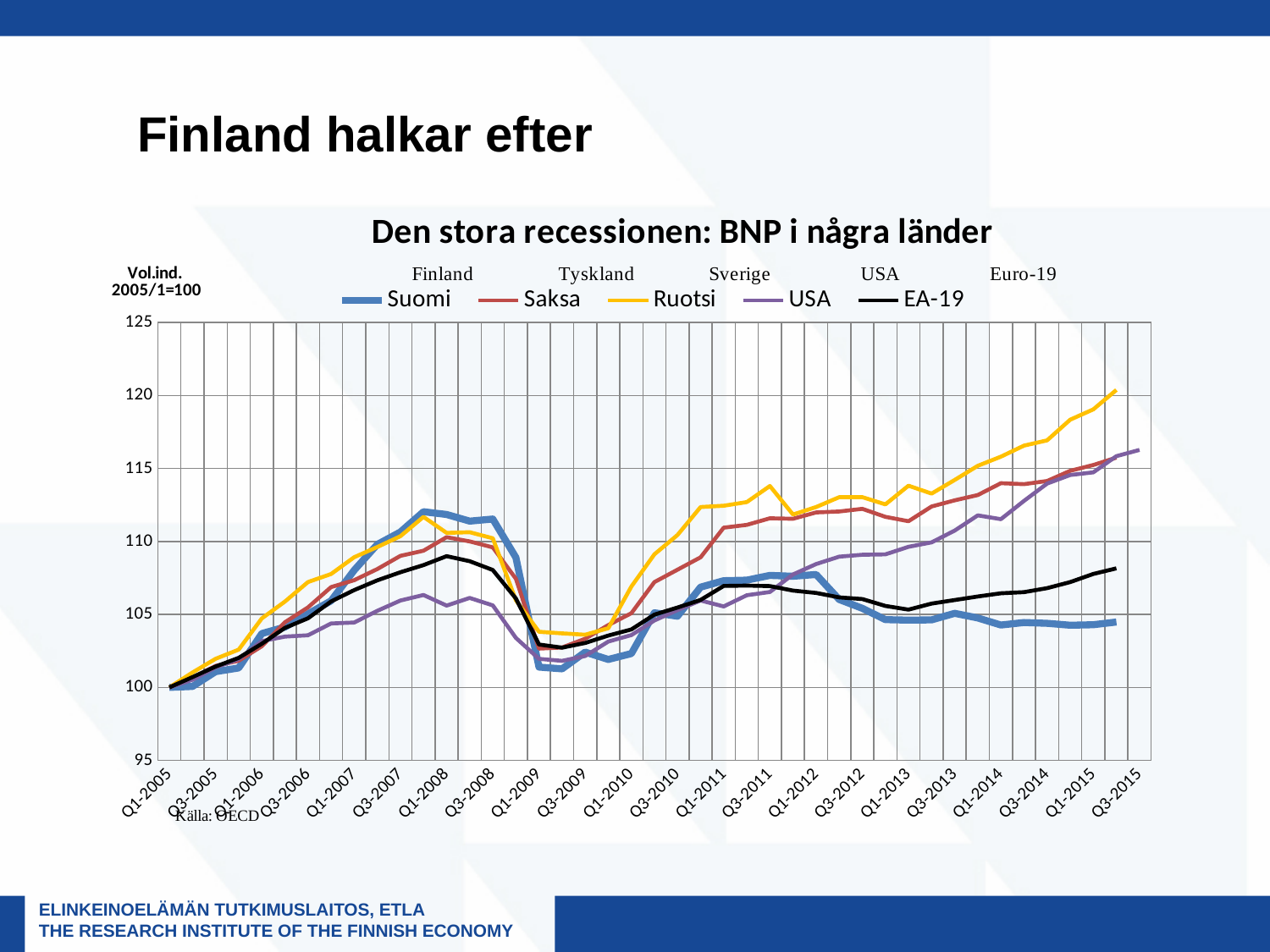
At Q1-2008, which series is higher, Suomi or USA? Suomi Does the Suomi series rise or fall between Q1-2011 and Q3-2015? fall Which series are listed in the chart legend? Suomi, Saksa, Ruotsi, USA, EA-19 How many series does the chart legend list? 5 Does the Ruotsi series rise or fall between Q1-2010 and Q3-2015? rise What kind of chart is shown on the slide? line chart What is the title of the chart? Den stora recessionen: BNP i några länder